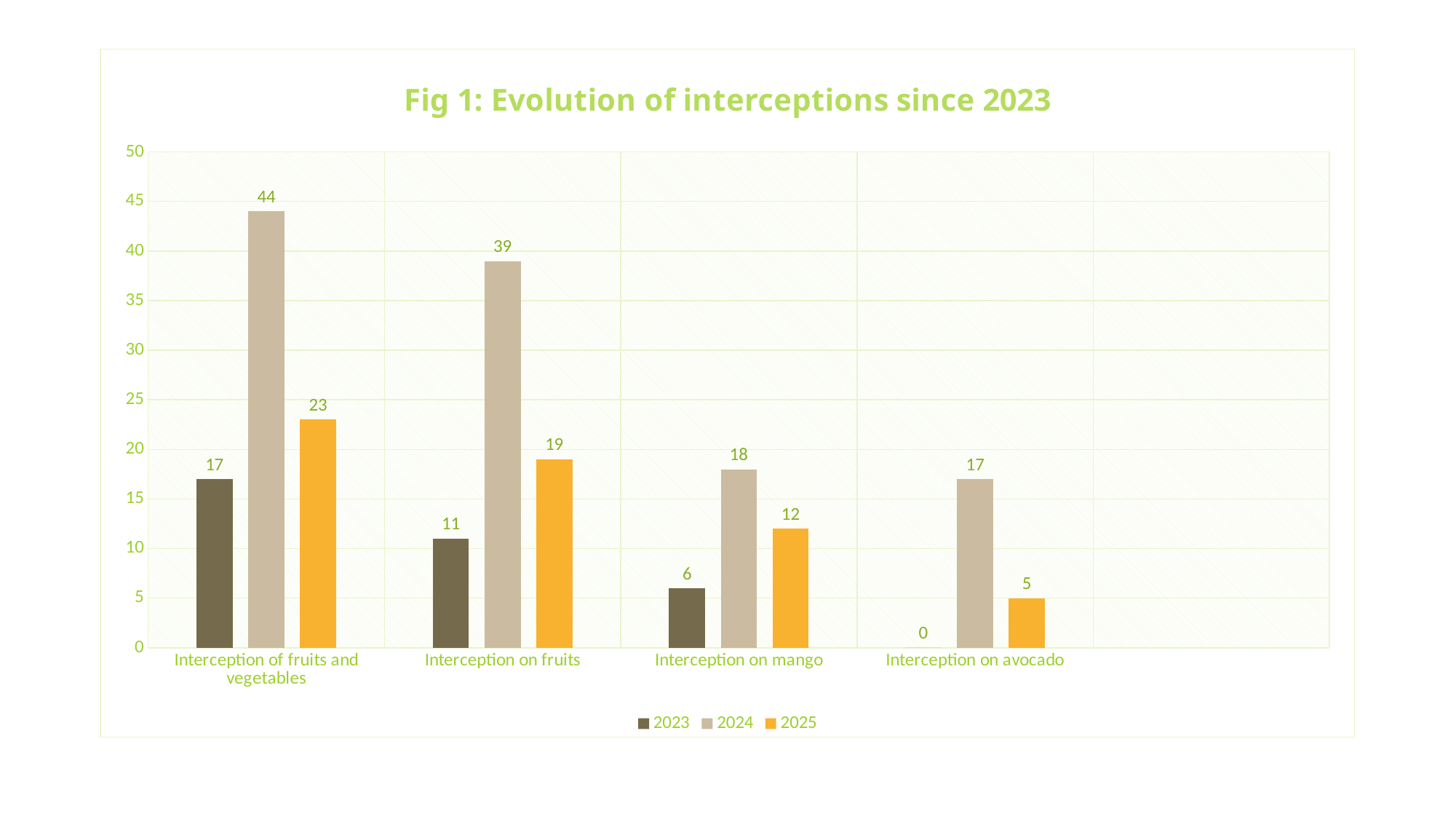
What is the 2023 value for Interception on mango? 6 Which is larger: the 2025 value for Interception on mango or the 2025 value for Interception on fruits? Interception on fruits What is the 2024 value for Interception of fruits and vegetables? 44 Is the 2024 value for Interception on mango greater or less than 20? less What kind of chart is shown? bar chart What is the difference between the 2024 and 2023 values for Interception on fruits? 28 What is the 2025 value for Interception on avocado? 5 How many series does the legend list? 3 Which category has the lowest 2023 value? Interception on avocado Which category has the highest 2025 value? Interception of fruits and vegetables How many categories are shown on the x axis? 4 What is the title of the chart? Fig 1: Evolution of interceptions since 2023